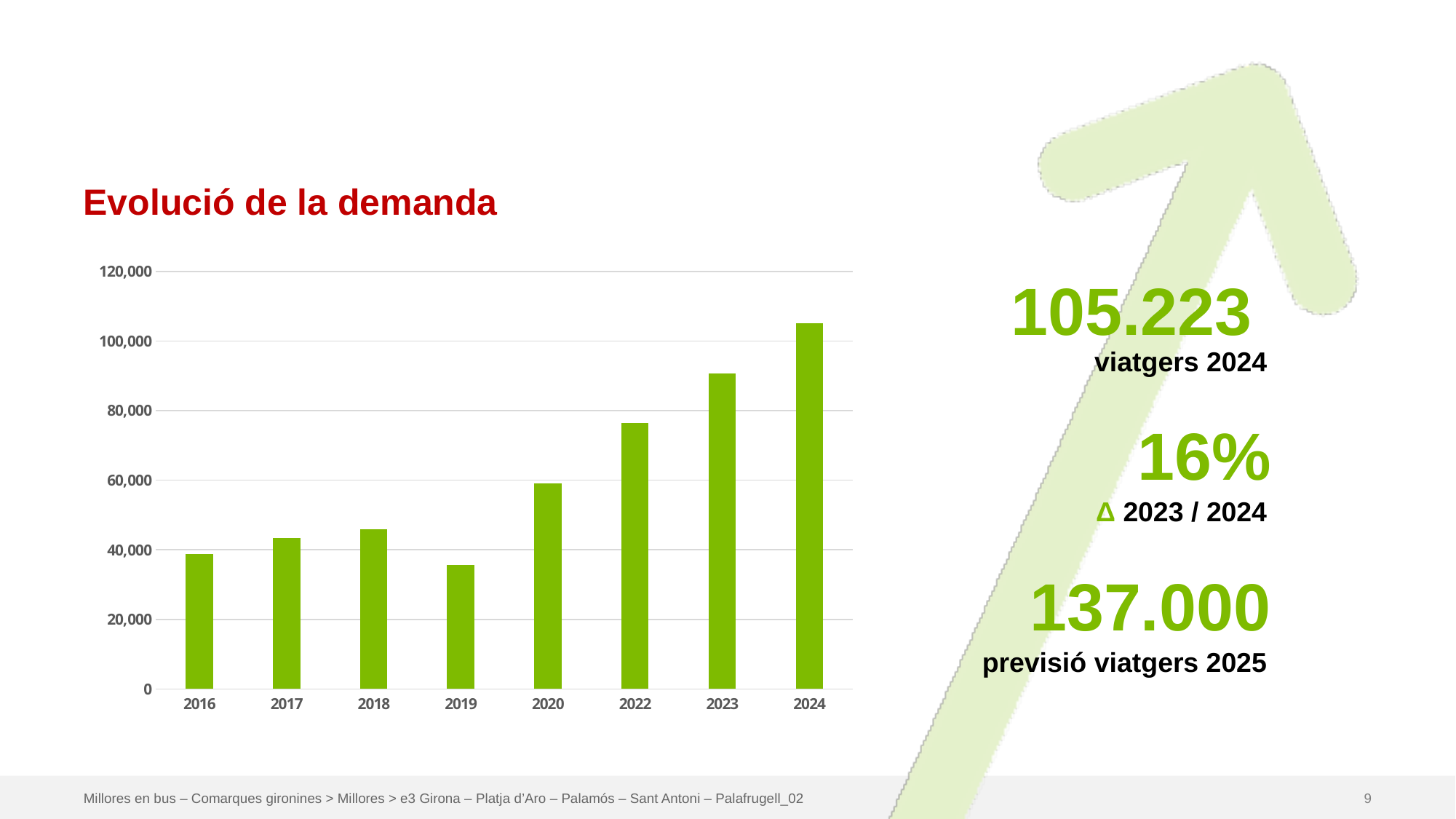
Is the value for 2023 greater or less than 80,000? greater Is the value for 2018 greater or less than 40,000? greater Which year has the lowest bar in the chart? 2019 Is the value for 2024 greater or less than 100,000? greater How many years are shown on the x axis of the chart? 8 Overall, do the values rise or fall from 2016 to 2024? rise Which year has the larger value, 2022 or 2023? 2023 What kind of chart is shown on the slide? bar chart What is the title of the chart? Evolució de la demanda Which year has the highest bar in the chart? 2024